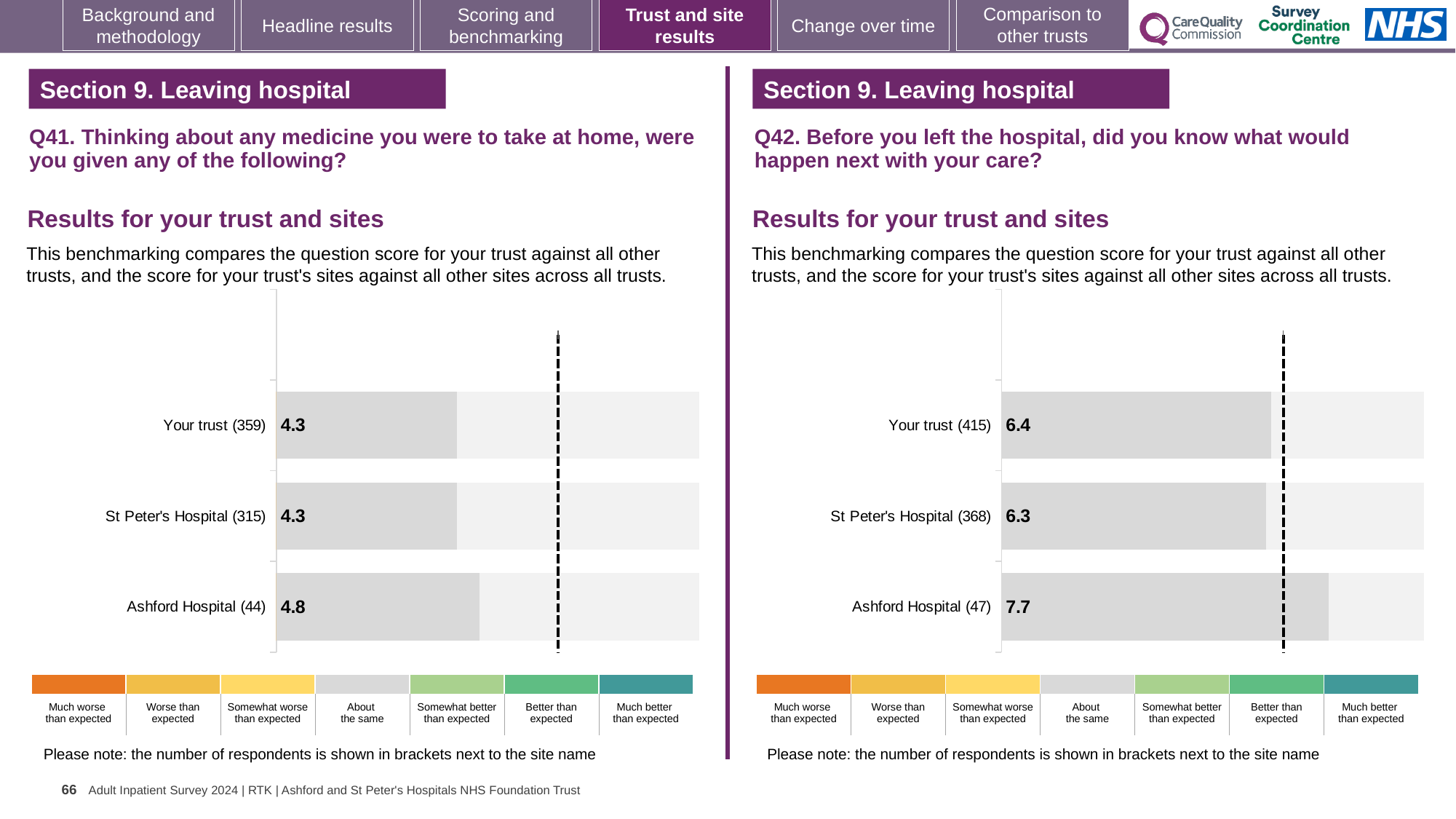
In the Q41 chart on the left, what is the score for Your trust? 4.3 In the Q42 chart on the right, which site or trust has the highest score? Ashford Hospital What type of chart is used for the Q42 results on the right? Bar chart In the Q42 chart on the right, is the score for Your trust or for St Peter's Hospital larger? Your trust How many bars are plotted in the Q41 chart on the left? 3 In the Q42 chart on the right, what is the score for Ashford Hospital? 7.7 In the Q41 chart on the left, what is the difference between the scores for Ashford Hospital and St Peter's Hospital? 0.5 In the Q41 chart on the left, what is the score for Ashford Hospital? 4.8 In the Q42 chart on the right, what is the score for St Peter's Hospital? 6.3 In the Q42 chart on the right, what is the difference between the scores for Ashford Hospital and Your trust? 1.3 In the Q42 chart on the right, which site or trust has the lowest score? St Peter's Hospital In the Q41 chart on the left, which has the highest score? Ashford Hospital